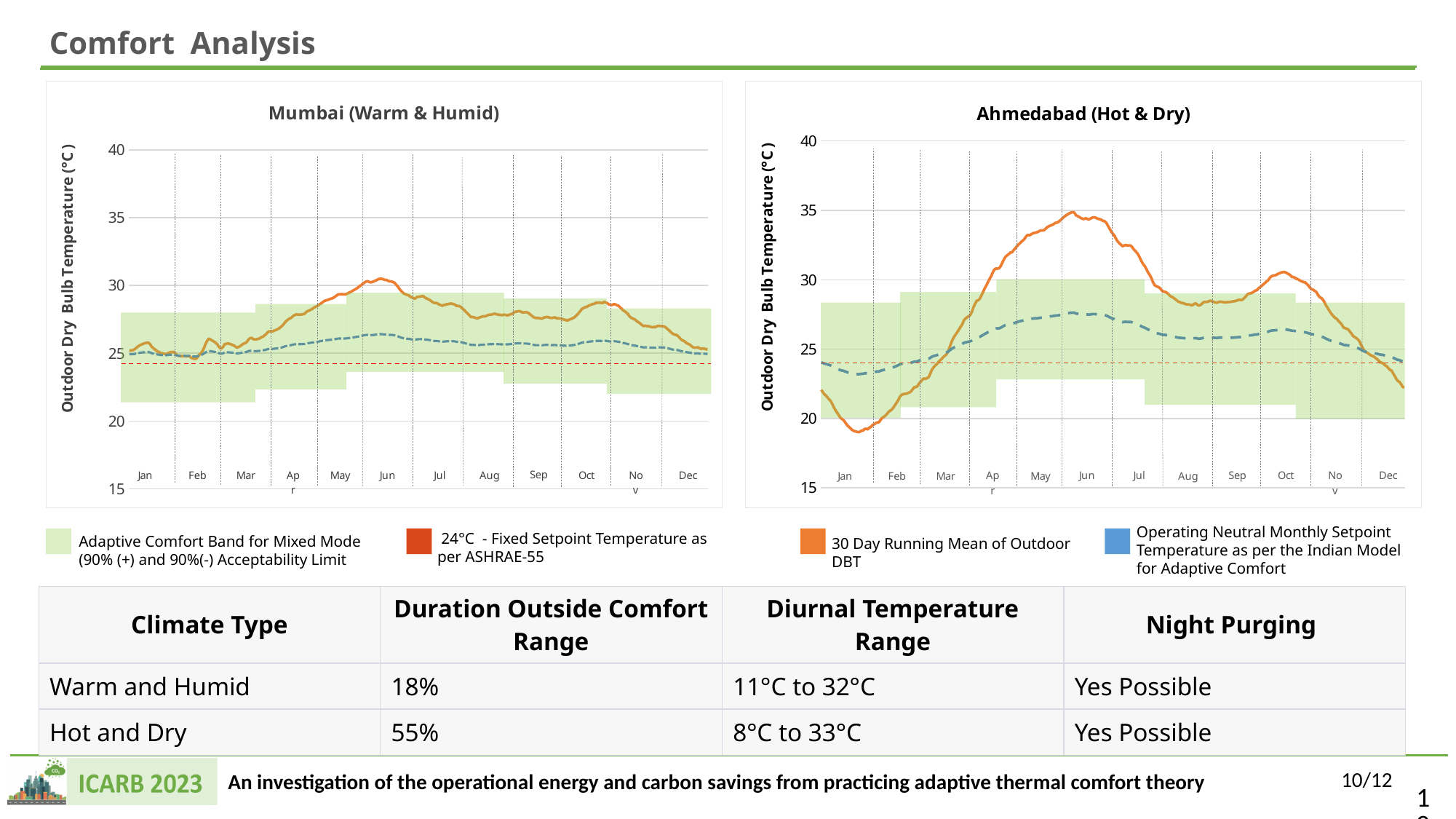
According to the legend, what fixed setpoint temperature as per ASHRAE-55 is shown on the charts? 24°C In the Ahmedabad (Hot & Dry) chart, is the 30 Day Running Mean of Outdoor DBT in June greater or less than 30? greater Which chart shows a higher 30 Day Running Mean of Outdoor DBT in June, Mumbai (Warm & Humid) or Ahmedabad (Hot & Dry)? Ahmedabad (Hot & Dry) What kind of chart is the Mumbai (Warm & Humid) chart? Line chart In the Mumbai (Warm & Humid) chart, does the 30 Day Running Mean of Outdoor DBT rise or fall from October to December? Fall What is the y-axis label of the Mumbai (Warm & Humid) chart? Outdoor Dry Bulb Temperature (°C) How many months are labelled along the x axis of the Ahmedabad (Hot & Dry) chart? 12 In the Ahmedabad (Hot & Dry) chart, in which month does the 30 Day Running Mean of Outdoor DBT reach its highest value? Jun In the Mumbai (Warm & Humid) chart, is the 30 Day Running Mean of Outdoor DBT in January greater or less than 30? less In the Ahmedabad (Hot & Dry) chart, is the 30 Day Running Mean of Outdoor DBT in February greater or less than 25? less In the Ahmedabad (Hot & Dry) chart, does the 30 Day Running Mean of Outdoor DBT rise or fall from January to June? Rise How many entries does the legend below the charts list? 4